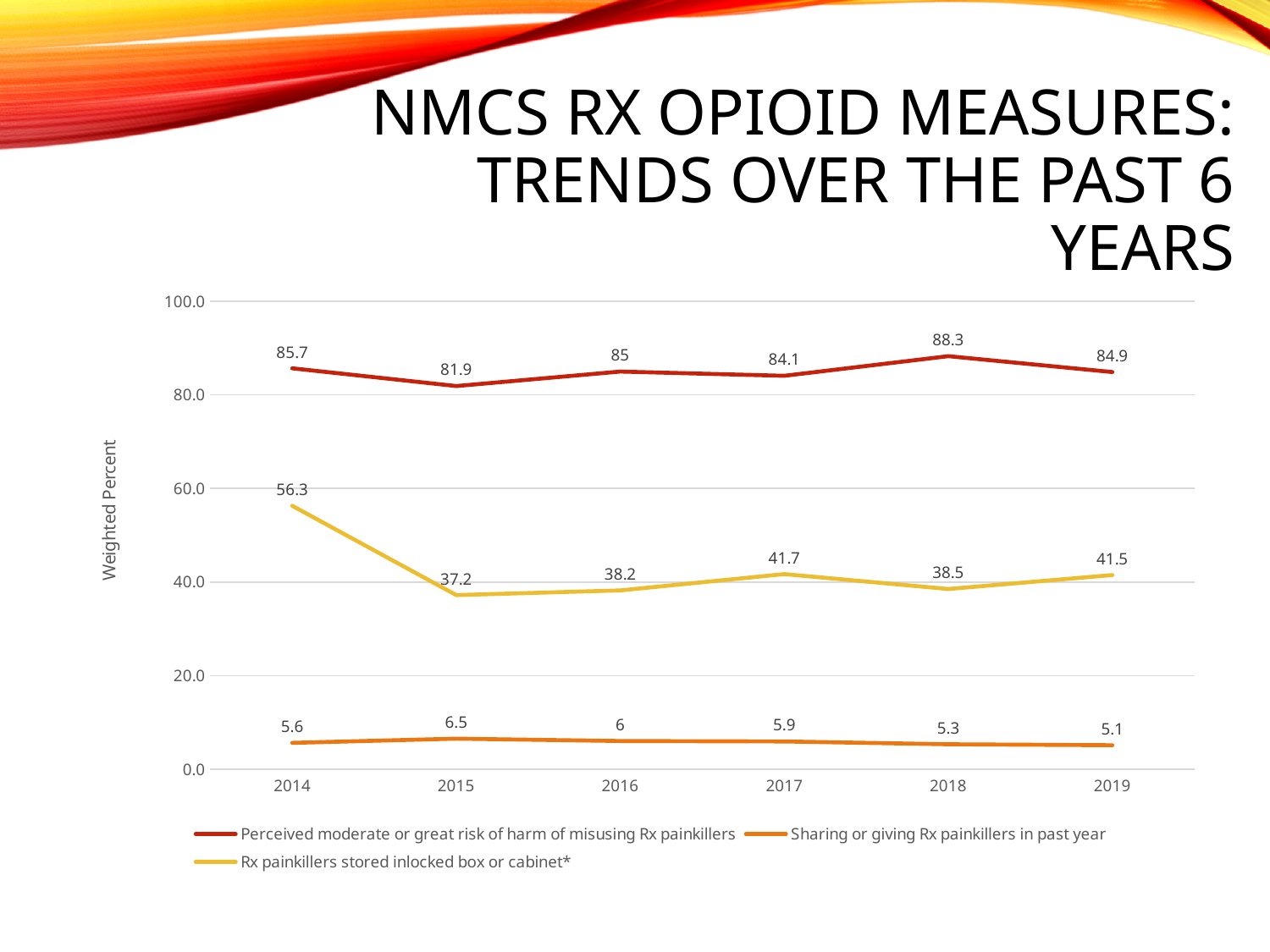
What kind of chart is shown on the slide? Line chart What is the value for 'Sharing or giving Rx painkillers in past year' in 2015? 6.5 What is the difference between the 2014 and 2015 values for 'Rx painkillers stored inlocked box or cabinet*'? 19.1 Does 'Sharing or giving Rx painkillers in past year' rise or fall from 2015 to 2019? Fall In which year is 'Rx painkillers stored inlocked box or cabinet*' lowest? 2015 In which year is 'Perceived moderate or great risk of harm of misusing Rx painkillers' highest? 2018 What is the value for 'Rx painkillers stored inlocked box or cabinet*' in 2014? 56.3 What is the label on the y axis? Weighted Percent Which is larger for 'Sharing or giving Rx painkillers in past year': the 2015 value or the 2019 value? 2015 What is the value for 'Perceived moderate or great risk of harm of misusing Rx painkillers' in 2018? 88.3 How many series does the legend list? 3 How many years are shown on the x axis? 6